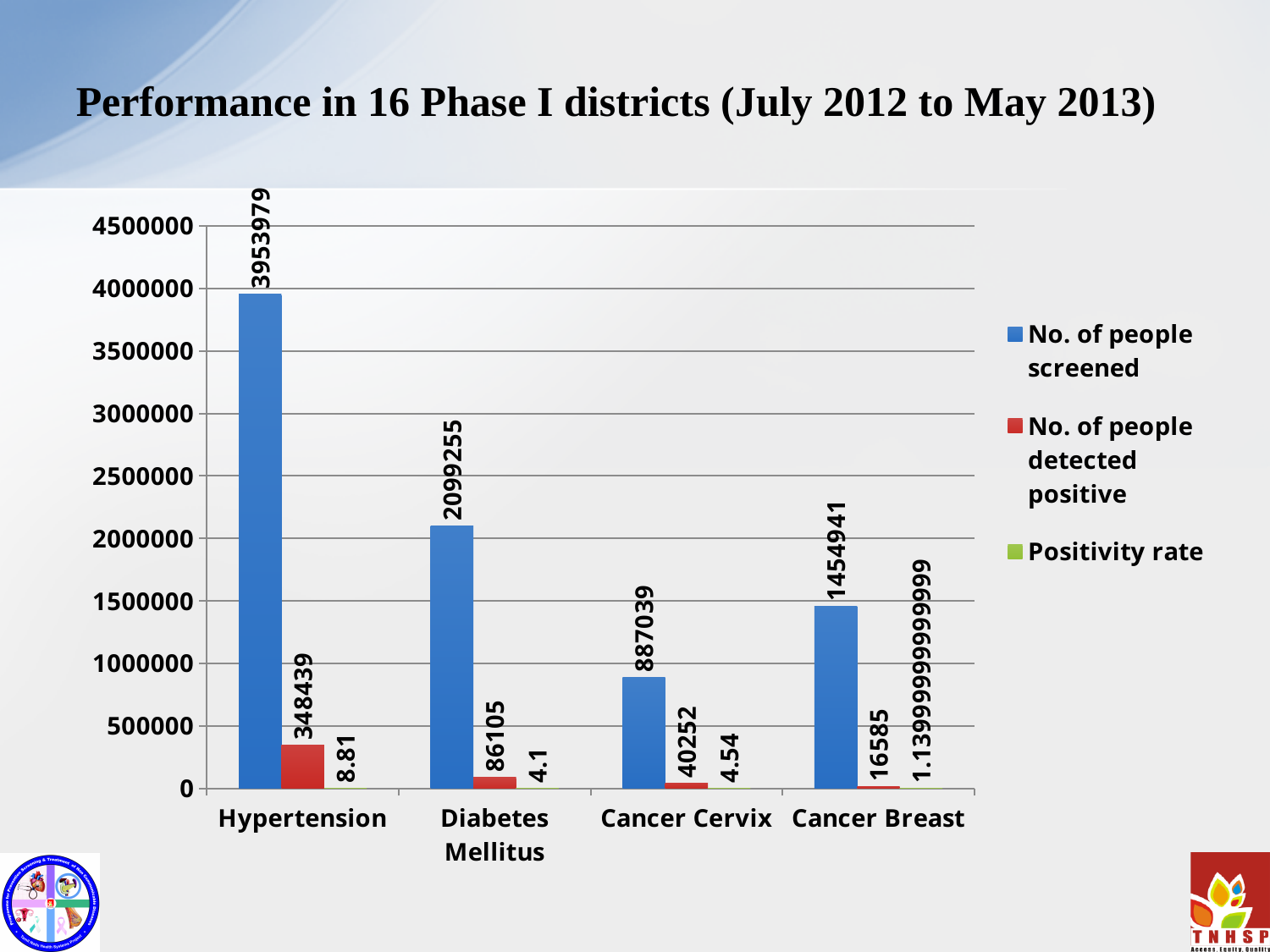
What is the difference between the number of people screened for Hypertension and for Diabetes Mellitus? 1854724 What kind of chart is shown on the slide? bar chart How many series does the legend list? 3 Which category has the lowest number of people detected positive? Cancer Breast Which category has the highest number of people screened? Hypertension Is the number of people screened for Diabetes Mellitus greater or less than 2000000? greater What is the number of people screened for Cancer Breast? 1454941 What is the number of people screened for Hypertension? 3953979 What is the positivity rate for Cancer Cervix? 4.54 Which is larger: the number of people screened for Cancer Cervix or for Cancer Breast? Cancer Breast How many categories are shown on the x axis? 4 What is the number of people detected positive for Diabetes Mellitus? 86105